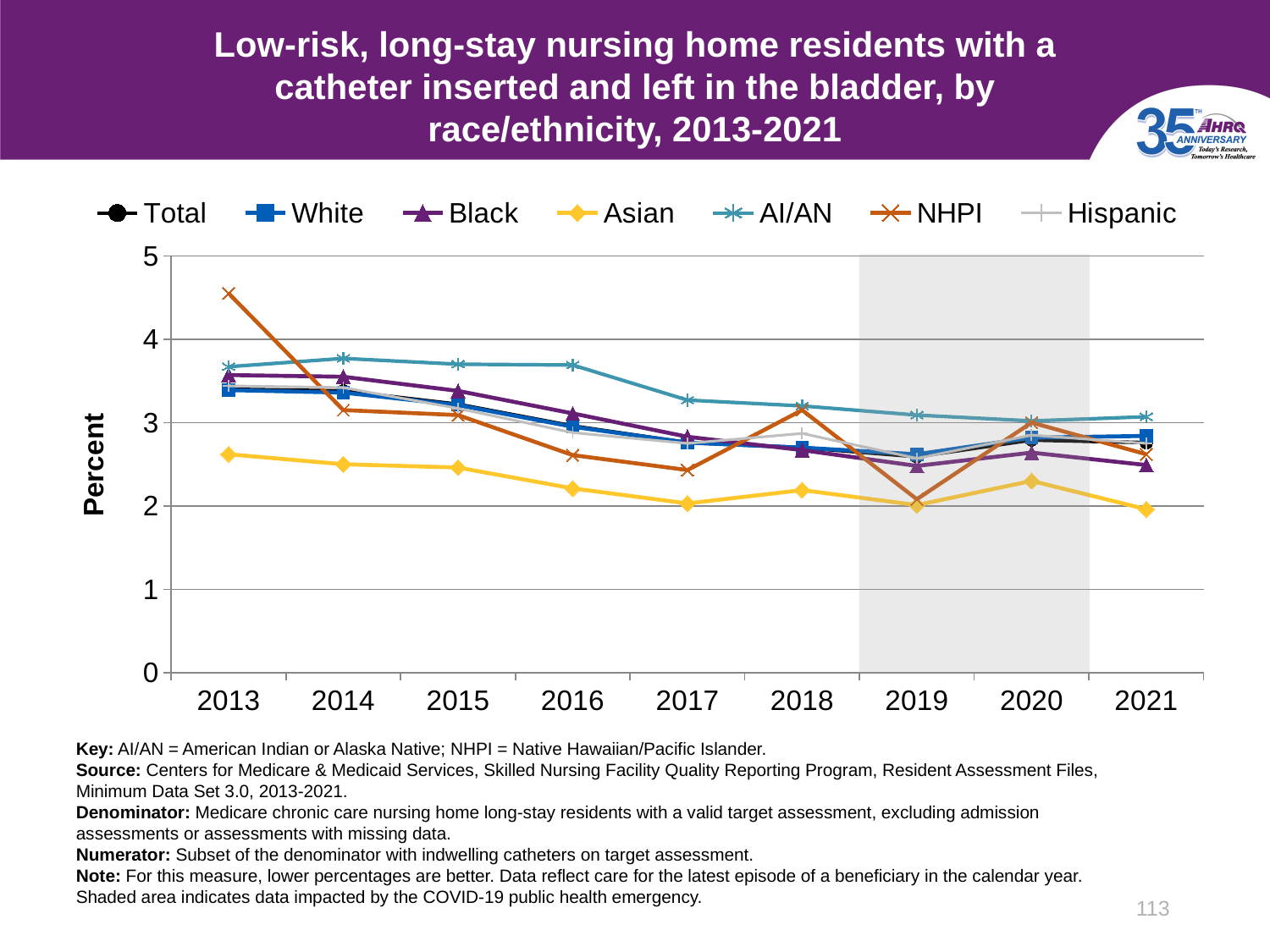
What kind of chart is shown on the slide? Line chart Which race/ethnicity group has the lowest value in 2013? Asian How many series does the legend list? 7 In 2018, which is larger: the value for AI/AN or the value for Asian? AI/AN Which race/ethnicity group has the lowest value in 2021? Asian Is the value for NHPI in 2013 greater or less than 4? greater Is the value for AI/AN in 2016 greater or less than 3? greater Which race/ethnicity group has the highest value in 2013? NHPI Does the Asian line generally rise or fall from 2013 to 2021? Fall What is the label on the y axis? Percent How many years are shown along the x axis? 9